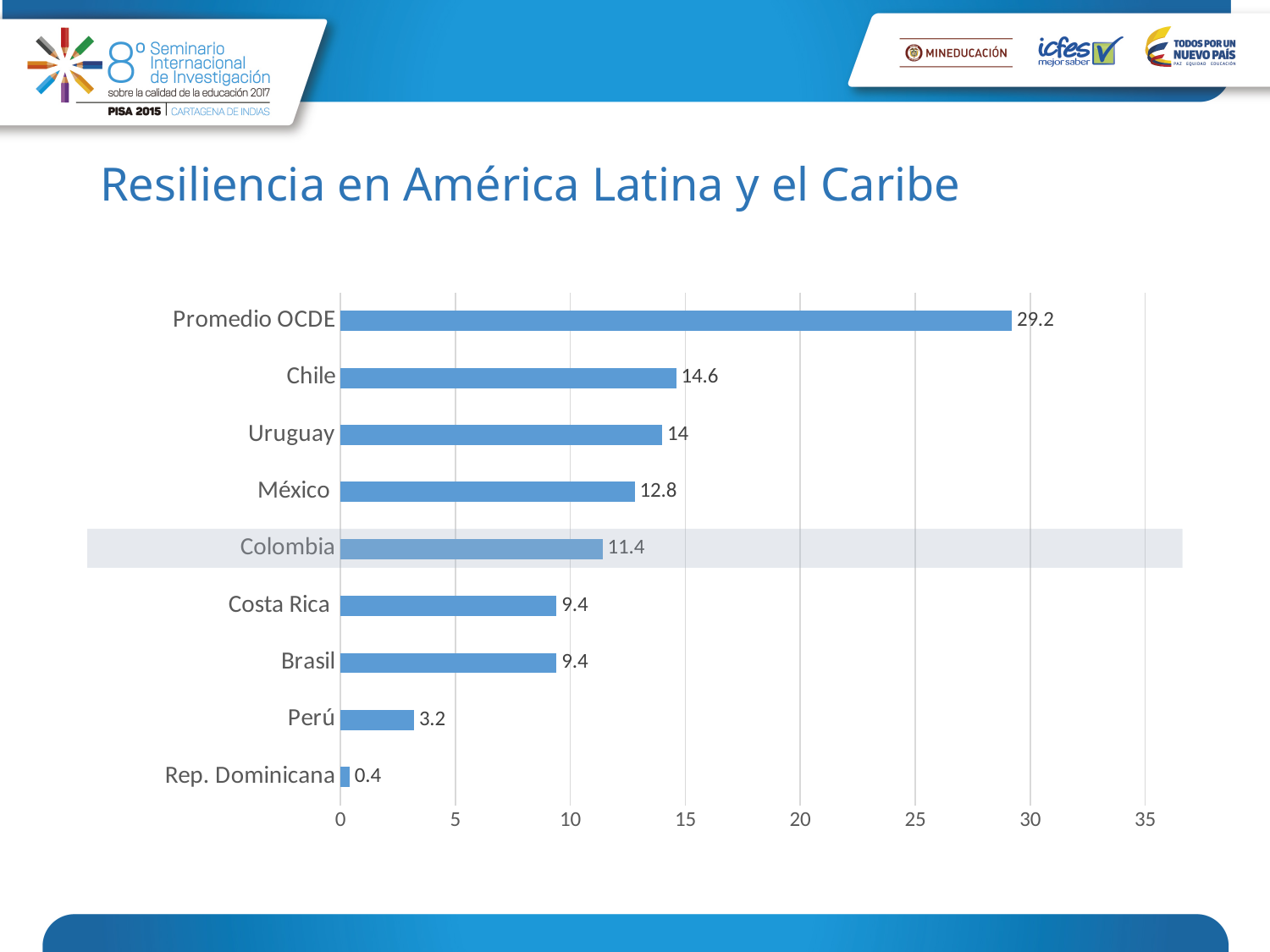
What is the value for Colombia? 11.4 Is the value for Uruguay greater or less than 10? greater How many categories are shown in the chart? 9 Which category has the highest value? Promedio OCDE Which has a larger value, México or Costa Rica? México What is the difference between the values for Chile and Uruguay? 0.6 What kind of chart is shown on the slide? Bar chart What is the difference between the values for Promedio OCDE and Colombia? 17.8 What is the title of the slide? Resiliencia en América Latina y el Caribe What is the value for Chile? 14.6 Which category has the lowest value? Rep. Dominicana What is the value for Rep. Dominicana? 0.4